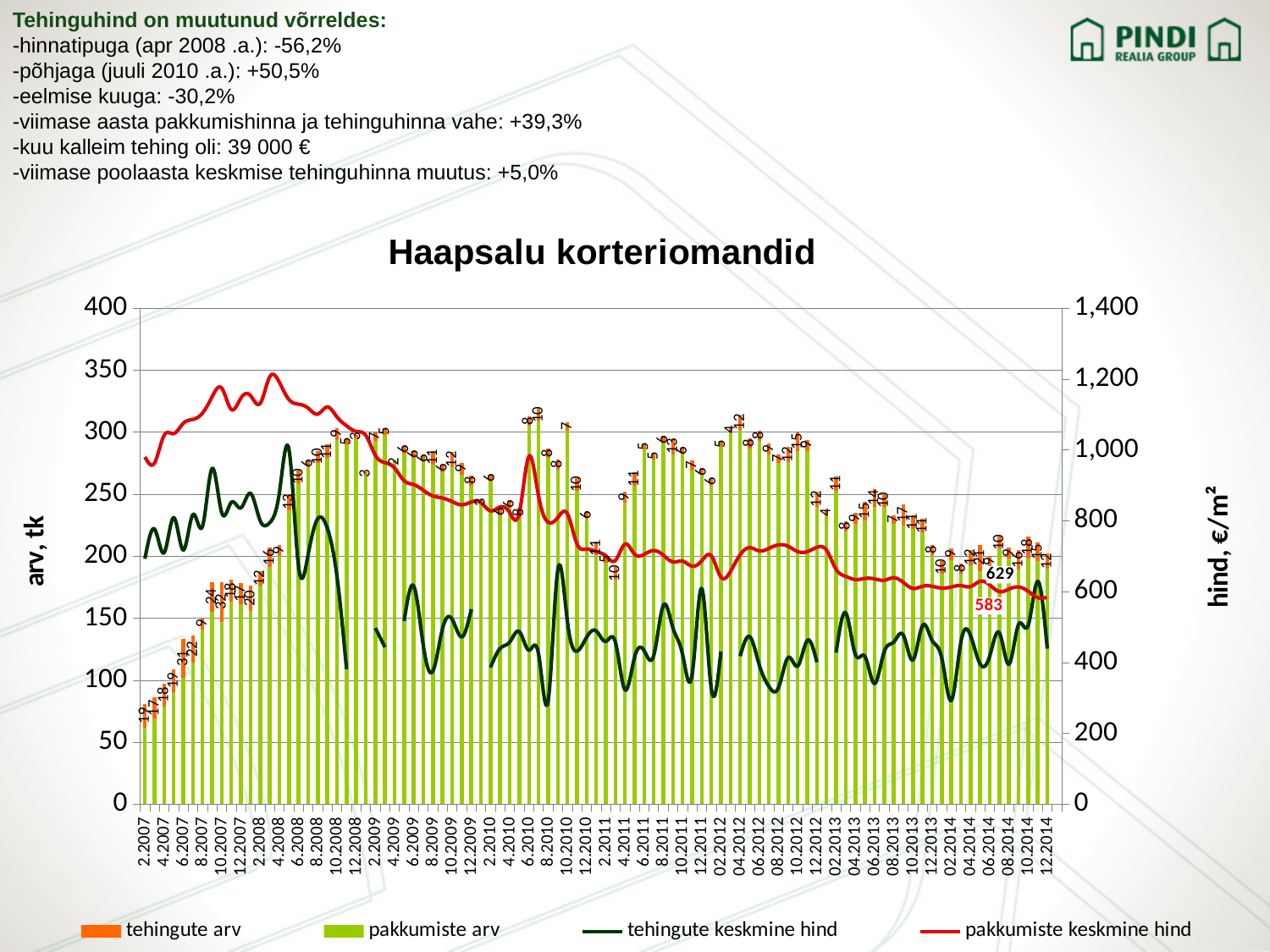
What value is printed as a data label on the tehingute keskmine hind line near 08.2014? 629 Is the value of pakkumiste arv at 2.2007 greater or less than 100? less What value is printed in red on the chart for pakkumiste keskmine hind at the end of the series? 583 At 12.2014, which is higher: pakkumiste keskmine hind or tehingute keskmine hind? pakkumiste keskmine hind What is the label of the right-hand vertical axis? hind, €/m² What kind of chart is this? Combined bar and line chart Does pakkumiste keskmine hind rise or fall from its 2008 peak to 12.2014? fall How many series does the chart legend list? 4 What is the title of the chart? Haapsalu korteriomandid Is the peak value of pakkumiste keskmine hind in 2008 greater or less than 1,000 on the right axis? greater Is the value of pakkumiste keskmine hind at 12.2014 greater or less than 800? less Which series reaches the highest value on the right-hand price axis? pakkumiste keskmine hind